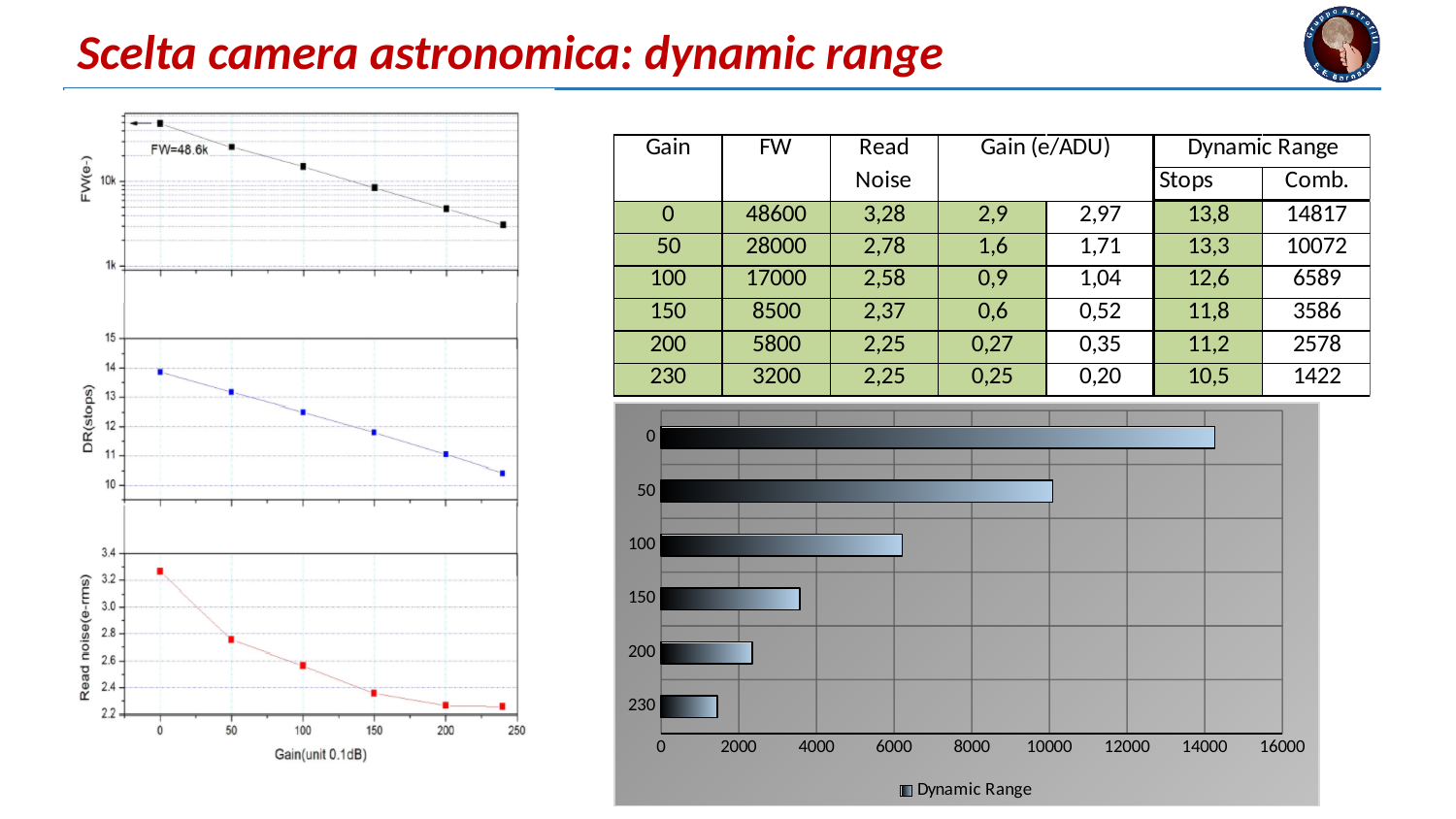
In the bar chart at the bottom right, which category has the longest bar? 0 In the bar chart at the bottom right, which bar is longer, the one for 50 or the one for 100? 50 In the bar chart at the bottom right, is the value for category 150 greater or less than 4000? less In the bar chart at the bottom right, is the value for category 230 greater or less than 2000? less What kind of chart is the chart at the bottom right of the slide? bar chart In the bar chart at the bottom right, how many categories are shown on the vertical axis? 6 In the bar chart at the bottom right, is the value for category 0 greater or less than 12000? greater How many series does the legend of the bar chart at the bottom right list? 1 In the bar chart at the bottom right, do the bar lengths rise or fall as the category values go from 0 to 230? fall In the middle line chart on the left (DR(stops) vs Gain), does DR rise or fall as gain increases? fall In the bar chart at the bottom right, which category has the shortest bar? 230 What is the legend entry of the bar chart at the bottom right? Dynamic Range